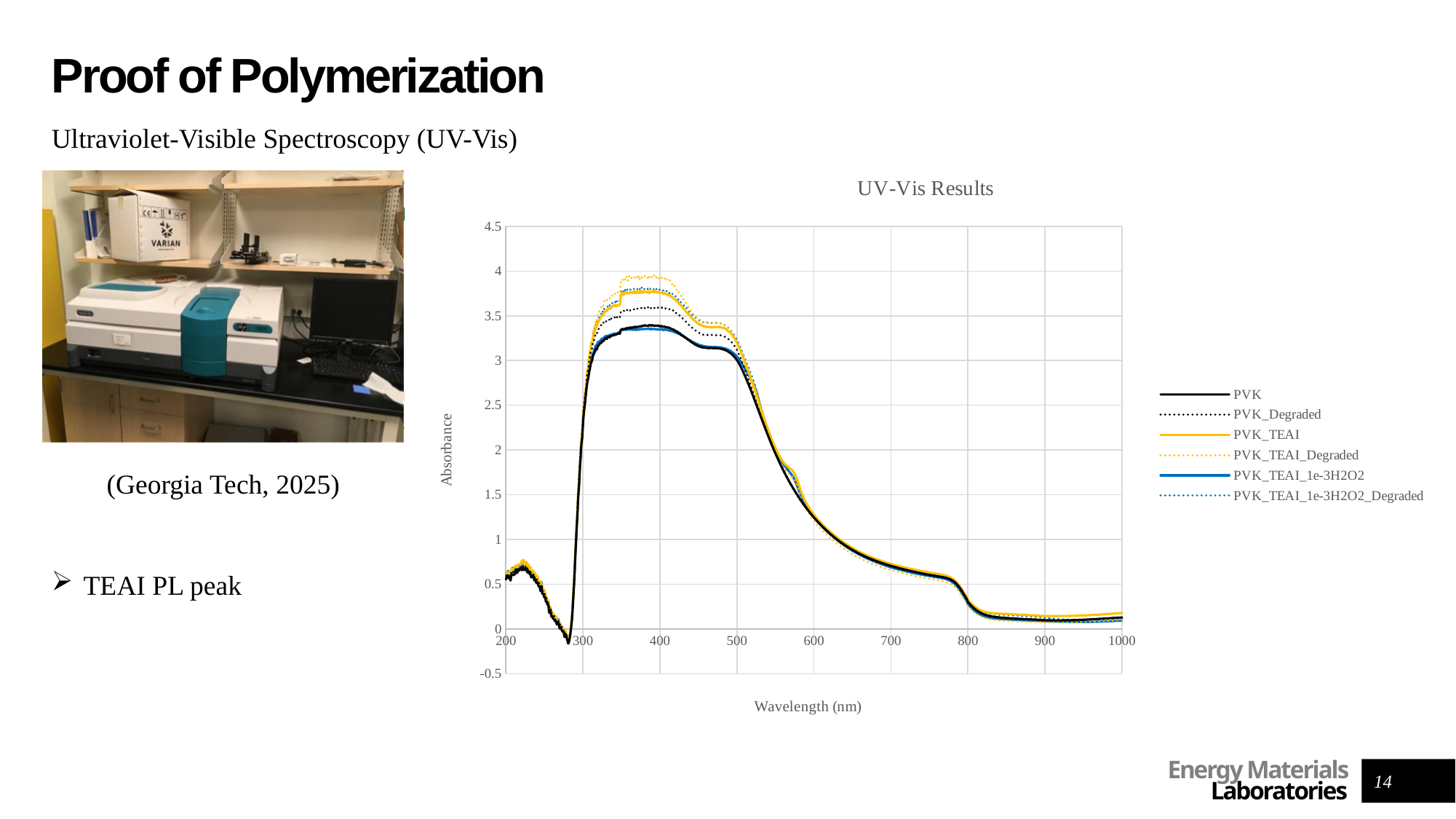
In the 'UV-Vis Results' chart, is the absorbance of PVK_TEAI at 700 nm greater or less than 1? less What is the title of the chart on the slide? UV-Vis Results In the 'UV-Vis Results' chart, which series has the highest absorbance at a wavelength of 400 nm? PVK_TEAI_Degraded In the 'UV-Vis Results' chart, is the absorbance of PVK at 400 nm greater or less than 3? greater How many series does the legend of the 'UV-Vis Results' chart list? 6 In the 'UV-Vis Results' chart, is the absorbance of PVK_TEAI_Degraded at 400 nm greater or less than 3.5? greater What is the label of the x axis of the 'UV-Vis Results' chart? Wavelength (nm) In the 'UV-Vis Results' chart, does the absorbance of PVK_TEAI rise or fall as the wavelength increases from 300 nm to 350 nm? rise In the 'UV-Vis Results' chart, does the absorbance of PVK rise or fall as the wavelength increases from 600 nm to 1000 nm? fall In the 'UV-Vis Results' chart, which series has the higher absorbance at 400 nm, PVK_TEAI or PVK? PVK_TEAI What kind of chart is the 'UV-Vis Results' chart? line chart